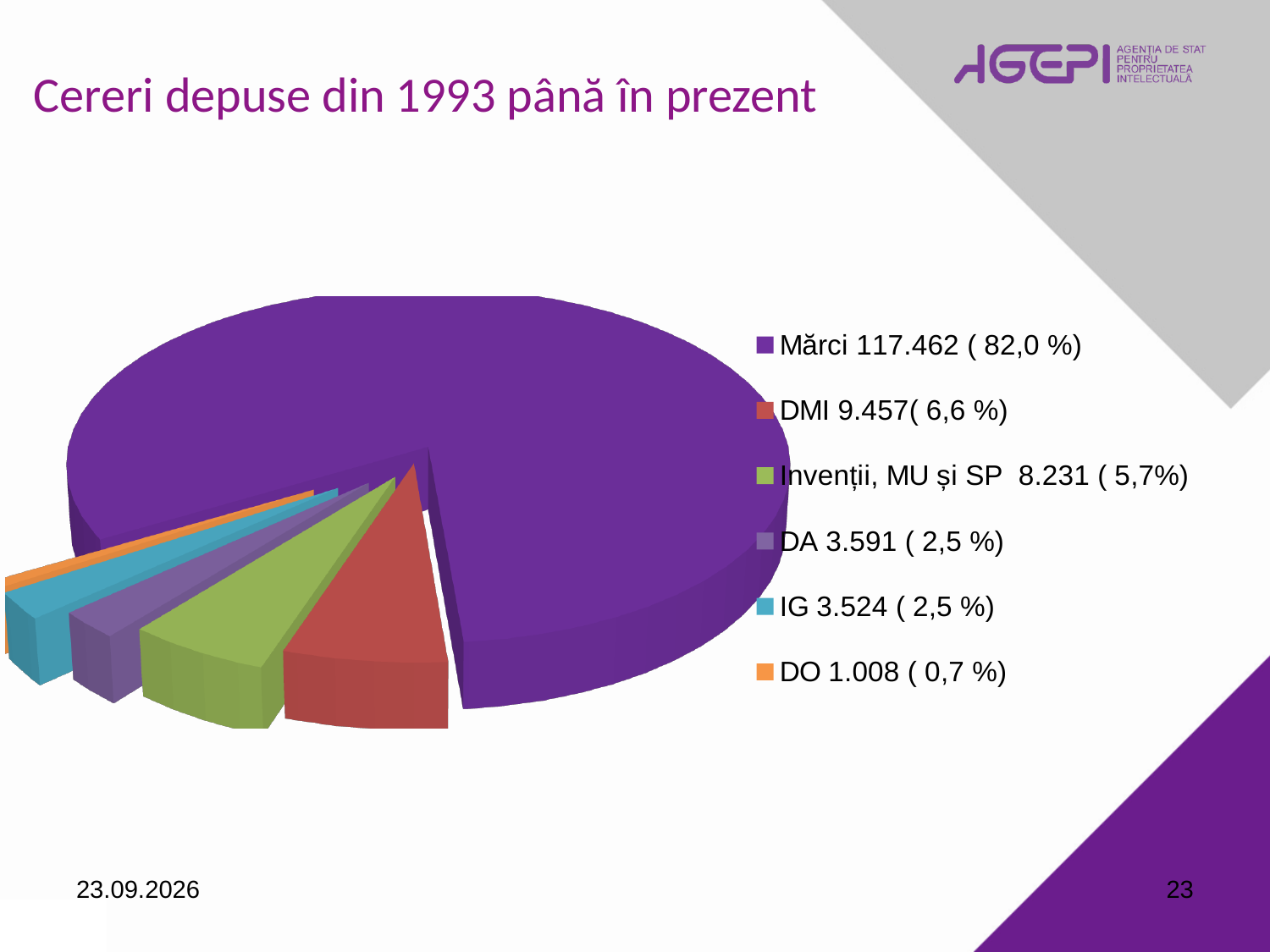
What is the title of the chart on the slide? Cereri depuse din 1993 până în prezent What share of the pie does DO represent? 0,7 % Which category has the largest slice of the pie? Mărci What is the value shown for Invenții, MU și SP? 8.231 What is the value shown for Mărci? 117.462 What kind of chart is shown on the slide? pie chart Which is larger, DMI or Invenții, MU și SP? DMI What is the value shown for DMI? 9.457 What share of the pie does Mărci represent? 82,0 % How many categories does the pie chart show? 6 Which category has the smallest slice of the pie? DO What is the difference between the values for DA and IG? 67